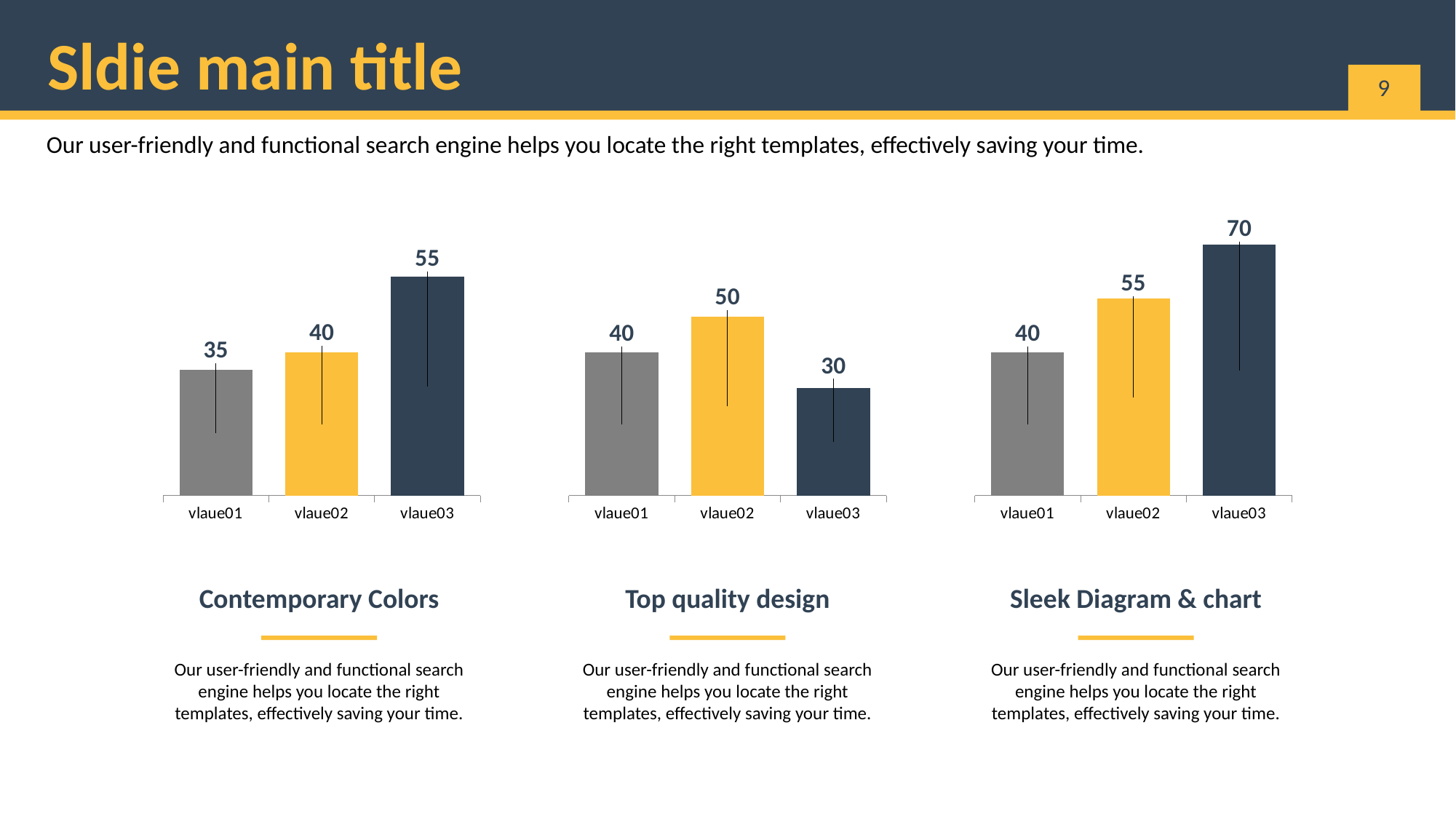
How many categories does the right chart show? 3 In the left chart, which category has the lowest value? vlaue01 In the right chart, what is the value for vlaue01? 40 In the right chart, what is the difference between the values for vlaue03 and vlaue02? 15 In the right chart, do the values rise or fall from vlaue01 to vlaue03? rise What kind of chart is the middle chart? bar chart In the left chart, what is the difference between the values for vlaue03 and vlaue01? 20 In the right chart, which category has the highest value? vlaue03 In the middle chart, which category has the lowest value? vlaue03 In the middle chart, which is larger, the value for vlaue01 or vlaue03? vlaue01 In the left chart, what is the value for vlaue03? 55 In the middle chart, what is the value for vlaue02? 50